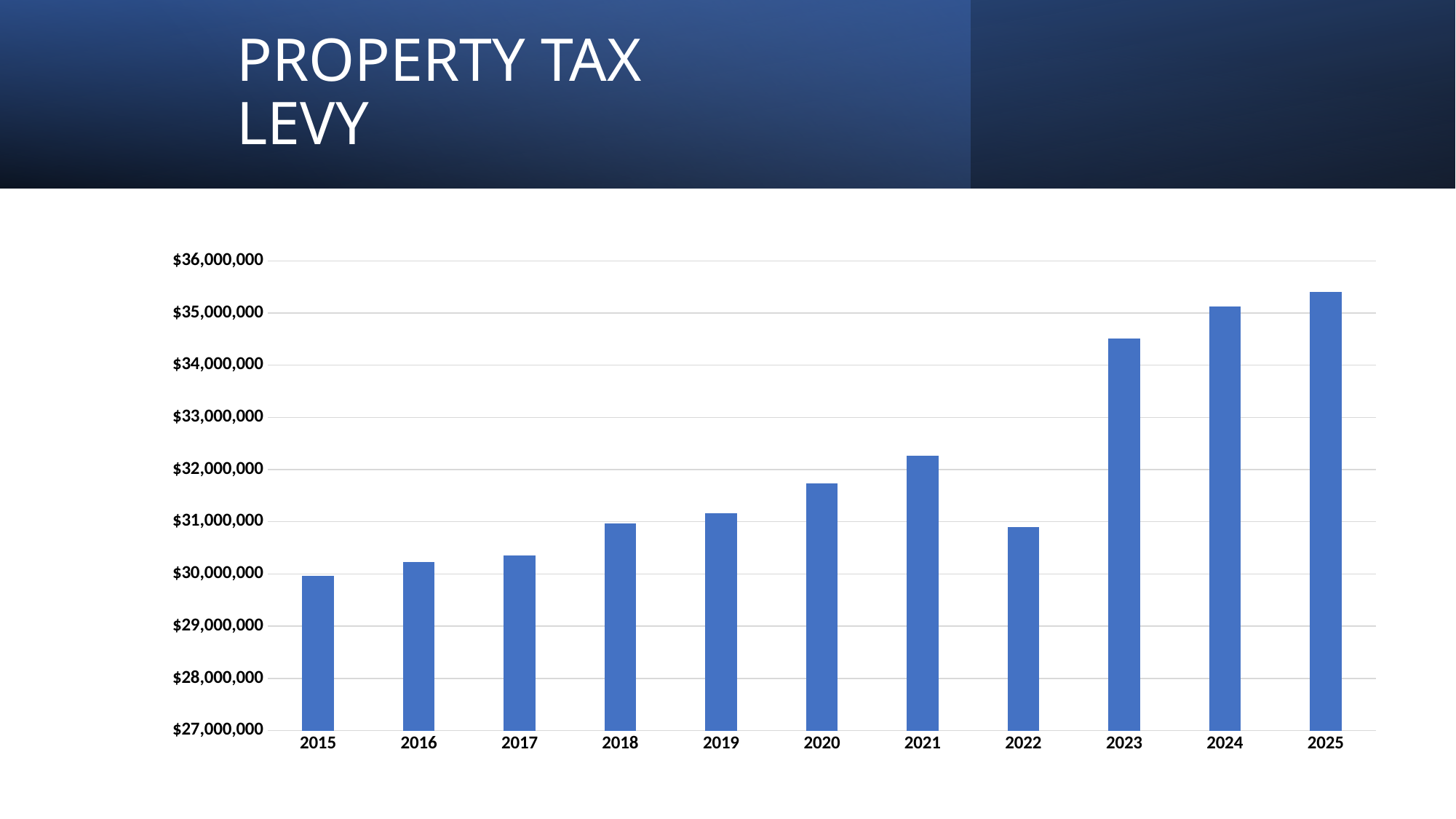
Is the value for 2016 greater or less than $31,000,000? less Which year has the lowest property tax levy? 2015 Is the value for 2023 greater or less than $34,000,000? greater How many years are shown on the x axis of the chart? 11 What kind of chart is shown on the slide? bar chart Which year has the larger property tax levy, 2020 or 2023? 2023 Is the value for 2020 greater or less than $31,000,000? greater Which year has the larger property tax levy, 2021 or 2022? 2021 Which year has the highest property tax levy? 2025 What is the title of the slide containing the chart? PROPERTY TAX LEVY Do the values rise or fall from 2022 to 2025? rise